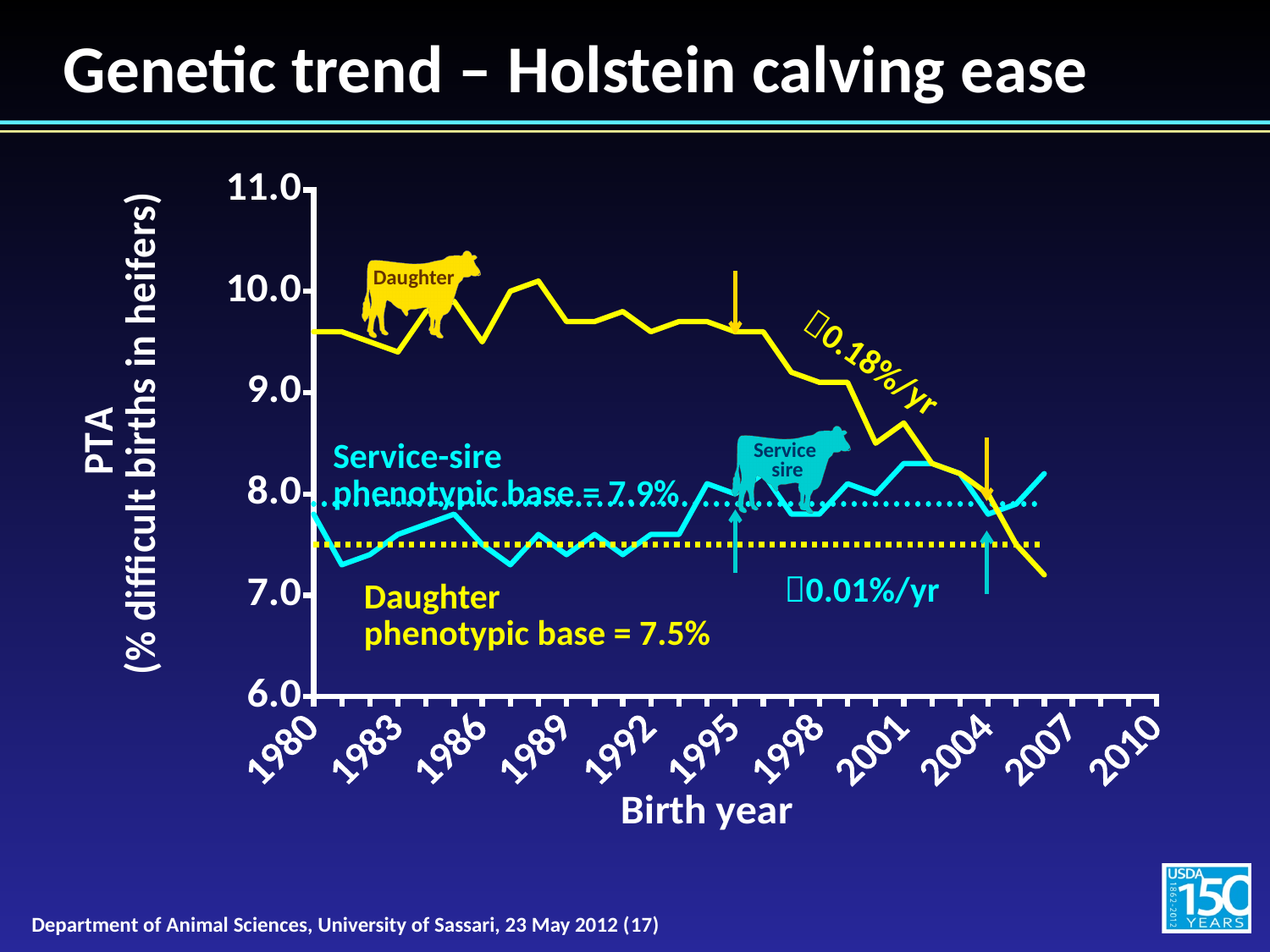
What is the Daughter phenotypic base shown on the chart? 7.5% What annual rate of change is annotated for the Service sire line? 0.01%/yr How many birth-year labels are shown on the x axis? 11 What kind of chart is shown on the slide? line chart What is the title of the x axis? Birth year For birth year 1990, which series has the higher value, Daughter or Service sire? Daughter What is the Service-sire phenotypic base shown on the chart? 7.9% Does the Daughter line rise or fall overall from 1980 to 2006? fall How many series are plotted on the chart? 4 What annual rate of change is annotated for the Daughter line? 0.18%/yr Is the Daughter value for birth year 1980 greater or less than 9.0? greater Is the Service sire value for birth year 1988 greater or less than 8.0? less